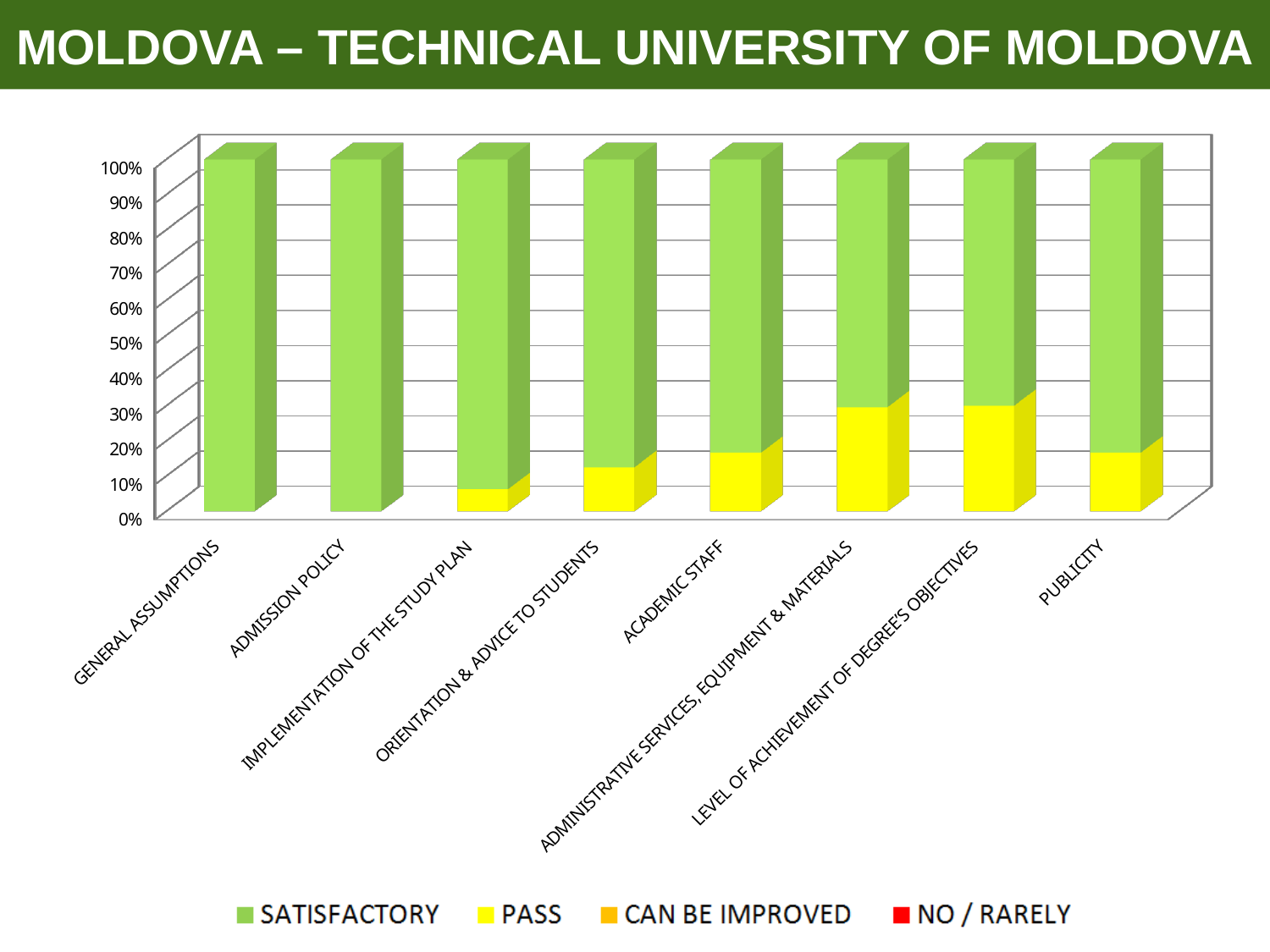
Which has a larger PASS share: ADMINISTRATIVE SERVICES, EQUIPMENT & MATERIALS or IMPLEMENTATION OF THE STUDY PLAN? ADMINISTRATIVE SERVICES, EQUIPMENT & MATERIALS Is the PASS share for ADMINISTRATIVE SERVICES, EQUIPMENT & MATERIALS greater or less than 20%? greater Is the PASS share for ACADEMIC STAFF greater or less than 30%? less How many series does the chart legend list? 4 Which has a larger PASS share: PUBLICITY or LEVEL OF ACHIEVEMENT OF DEGREE'S OBJECTIVES? LEVEL OF ACHIEVEMENT OF DEGREE'S OBJECTIVES Is the PASS share for ORIENTATION & ADVICE TO STUDENTS greater or less than 20%? less How many categories show no PASS (yellow) portion at all? 2 How many categories are shown along the x axis of the chart? 8 Which series is shown in yellow in the legend? PASS What kind of chart is shown on the slide? Stacked bar chart What is the total height of the stacked bar for GENERAL ASSUMPTIONS? 100%